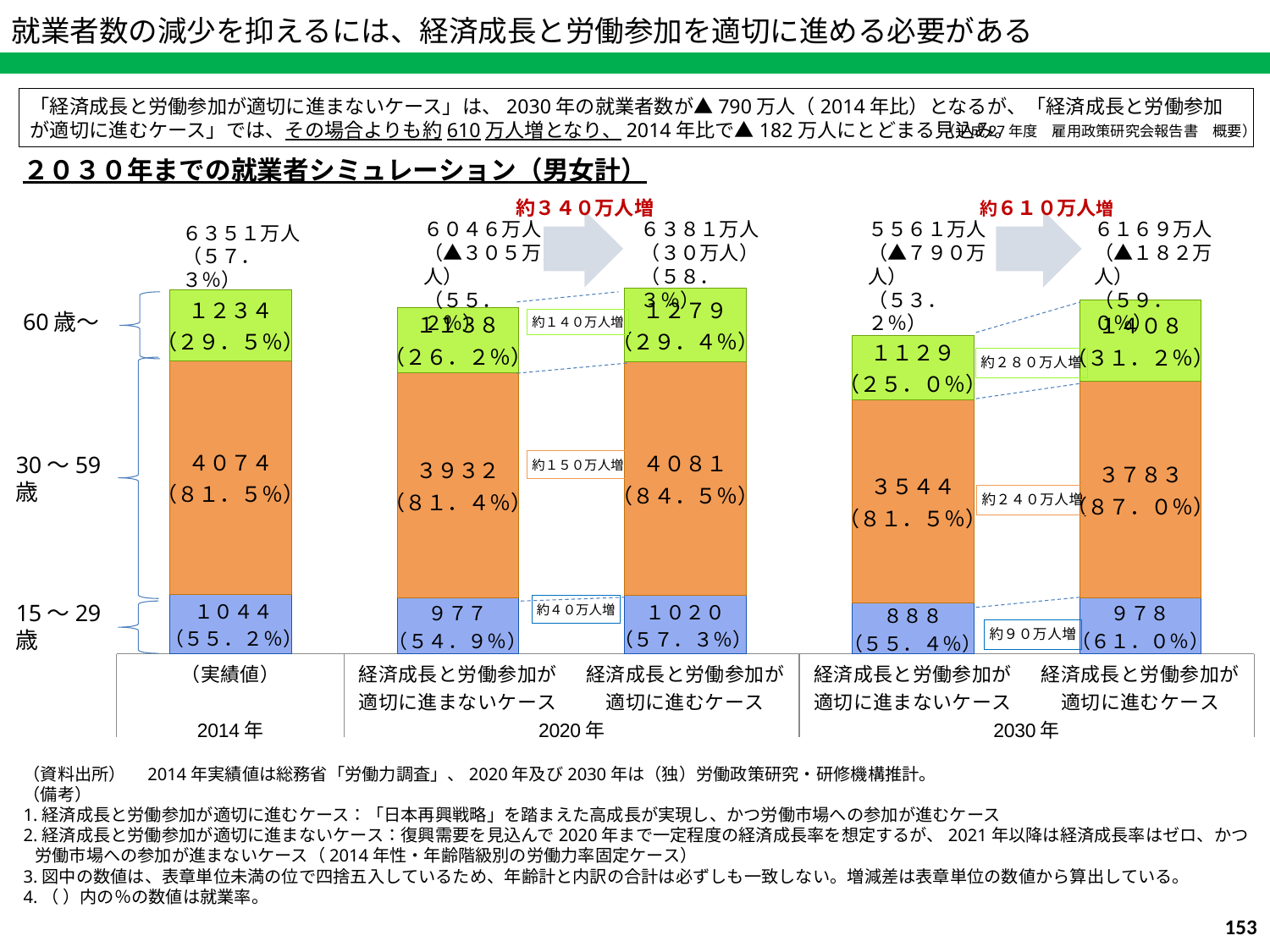
What does the red annotation above the arrow between the two 2030年 bars say? 約６１０万人増 What is the total shown above the 2030年 経済成長と労働参加が適切に進まないケース bar? 5561万人 How many bars are plotted in the chart? 5 What is the value for the 60歳～ segment in the 2030年 経済成長と労働参加が適切に進むケース bar? 1408 How many age groups (segments) make up each stacked bar? 3 What kind of chart is shown on the slide? stacked bar chart What is the difference between the 2014年 total (6351万人) and the 2030年 適切に進まないケース total (5561万人)? 790万人 Which is larger: the 15～29歳 value in 2014年 or the 15～29歳 value in the 2020年 適切に進むケース? 2014年 (1044) Which bar has the lowest total number of employed persons? 2030年 経済成長と労働参加が適切に進まないケース (5561万人) What is the value for the 15～29歳 segment in the 2014年 (実績値) bar? 1044 Which bar has the highest total number of employed persons? 2020年 経済成長と労働参加が適切に進むケース (6381万人) What employment rate (in parentheses) is shown for the 30～59歳 segment in the 2030年 適切に進むケース bar? 87.0%